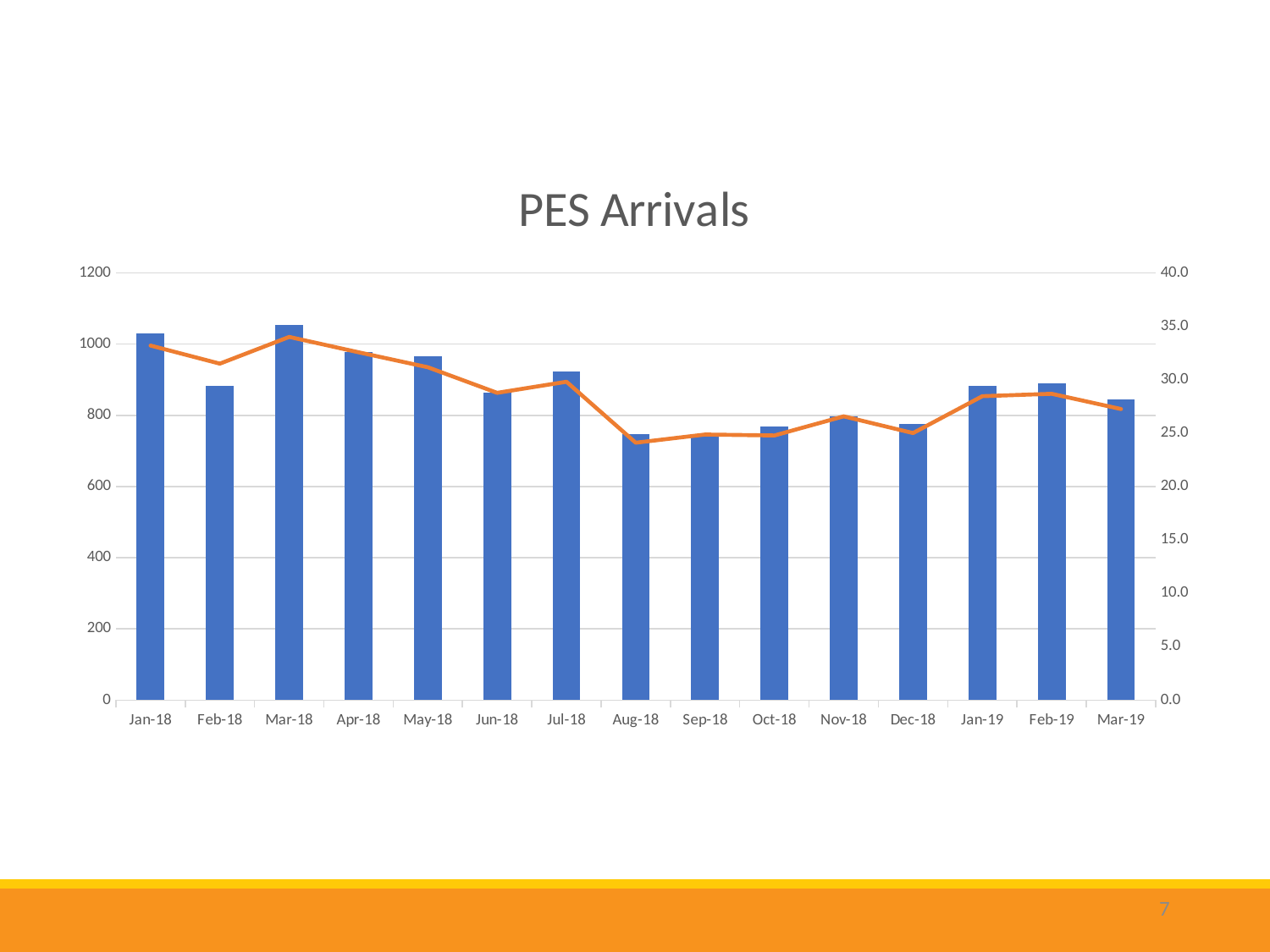
What kind of chart is shown on the slide? A bar chart with a line overlaid Do the bar values rise or fall from Mar-18 to Aug-18? fall Is the bar value for Mar-19 greater or less than 800? greater Is the orange line value for Jan-18 on the right axis greater or less than 30.0? greater Which has the taller bar, Mar-18 or Feb-18? Mar-18 Is the bar value for Feb-18 greater or less than 1000? less How many months are shown on the x axis? 15 Which has the taller bar, Jan-19 or Dec-18? Jan-19 Which month has the tallest bar? Mar-18 What is the title of the chart? PES Arrivals